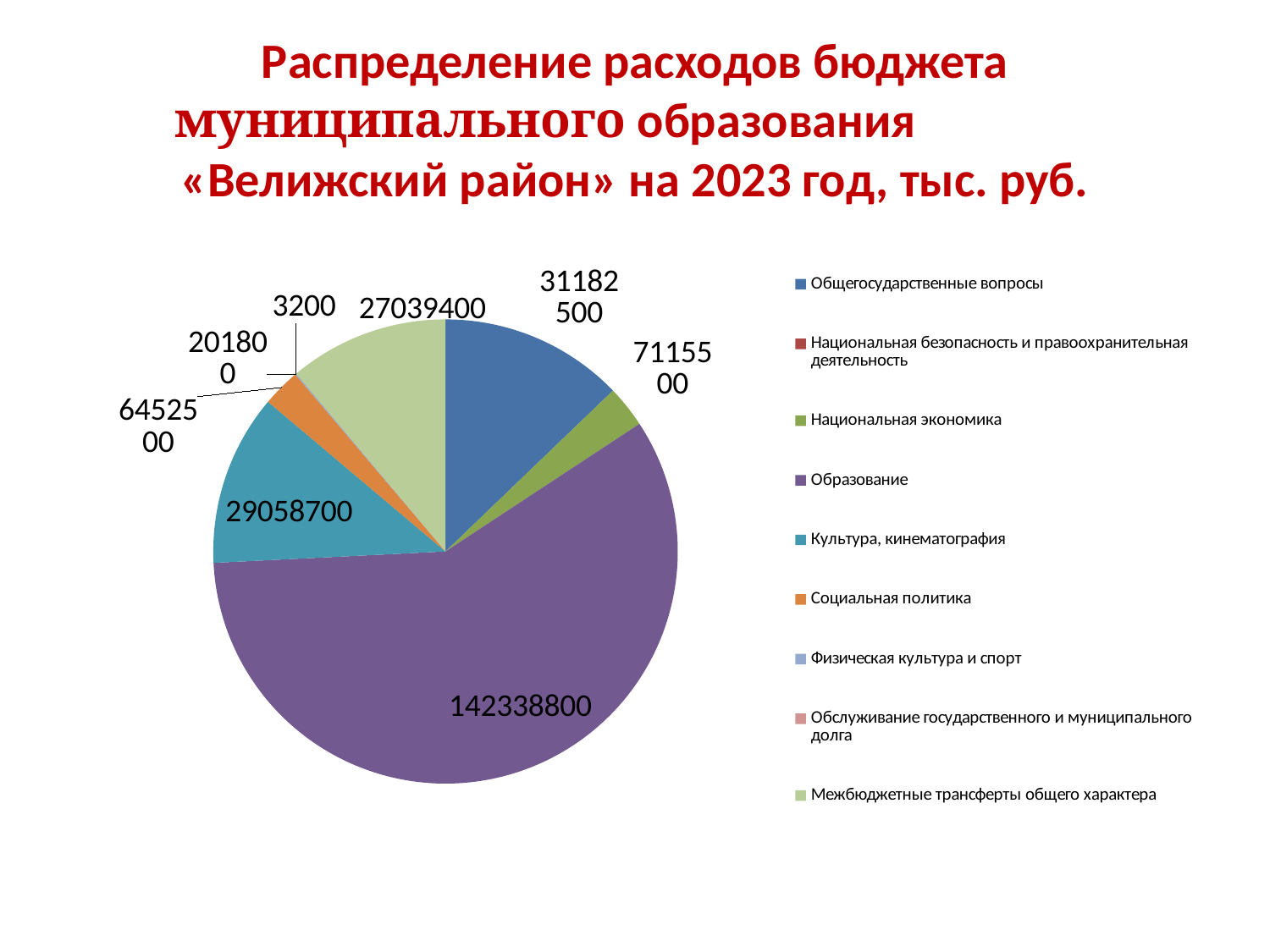
Which is larger, Общегосударственные вопросы or Культура, кинематография? Общегосударственные вопросы Which category has the largest slice of the pie? Образование What kind of chart is shown on the slide? pie chart How many categories does the legend list? 9 What is the value for Межбюджетные трансферты общего характера? 27039400 What colour is the Образование slice? purple What is the value for Национальная экономика? 7115500 What is the difference between Общегосударственные вопросы and Межбюджетные трансферты общего характера? 4143100 What is the value for Общегосударственные вопросы? 31182500 For which year does the chart show the budget expenditure distribution? 2023 What is the value for Образование? 142338800 What is the value for Культура, кинематография? 29058700